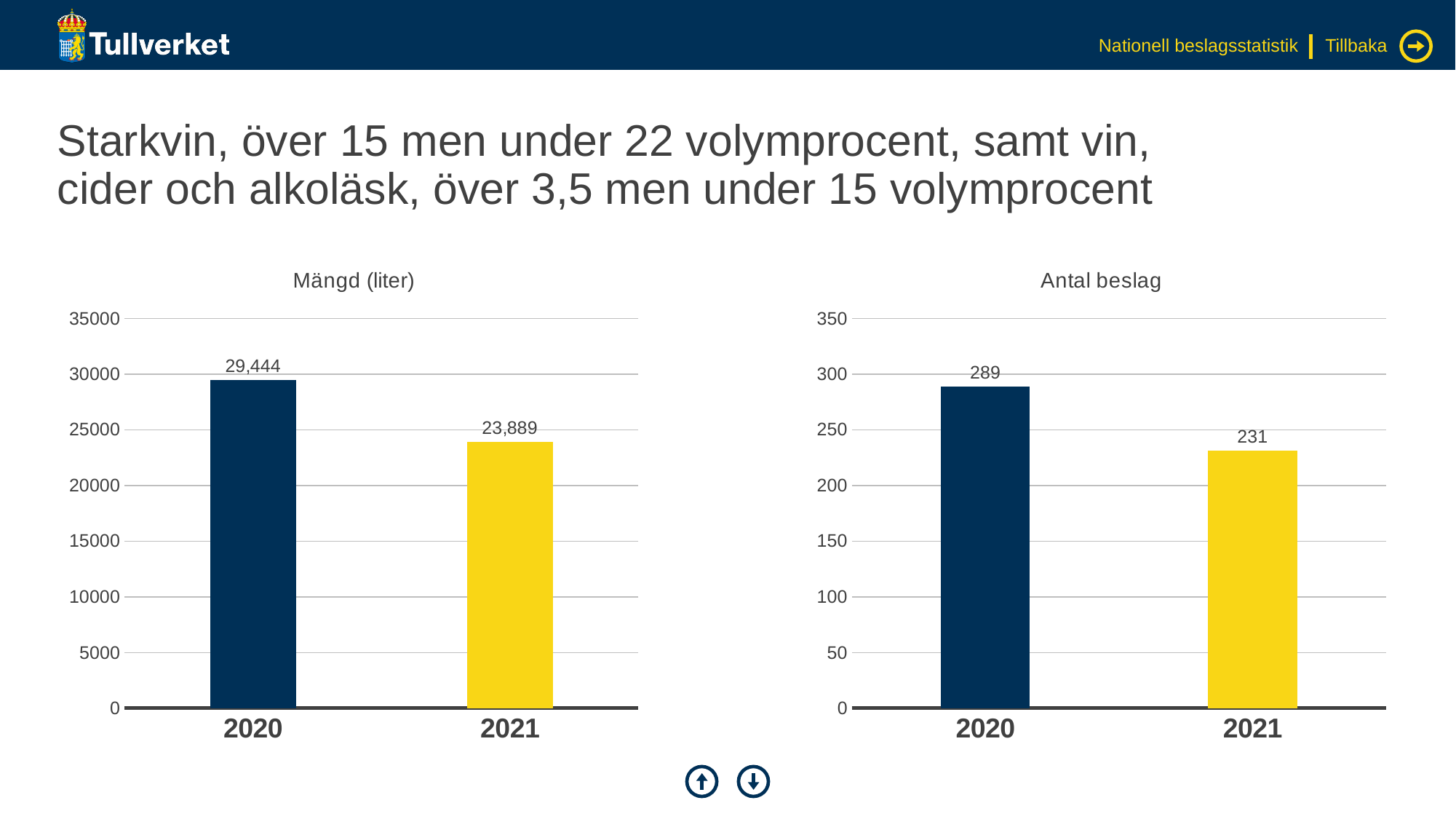
In the 'Mängd (liter)' chart, what is the value for 2021? 23,889 In the 'Antal beslag' chart, which year has the lowest value? 2021 What kind of chart is the 'Antal beslag' chart? bar chart In the 'Antal beslag' chart, what is the difference between the 2020 and 2021 values? 58 How many bars are shown in the 'Mängd (liter)' chart? 2 In the 'Mängd (liter)' chart, which year has the highest value? 2020 In the 'Antal beslag' chart, what is the value for 2021? 231 In the 'Mängd (liter)' chart, what is the value for 2020? 29,444 In the 'Antal beslag' chart, is the value for 2021 greater or less than 250? less In the 'Mängd (liter)' chart, what is the difference between the 2020 and 2021 values? 5,555 In the 'Antal beslag' chart, what is the value for 2020? 289 In the 'Mängd (liter)' chart, do the values rise or fall from 2020 to 2021? fall